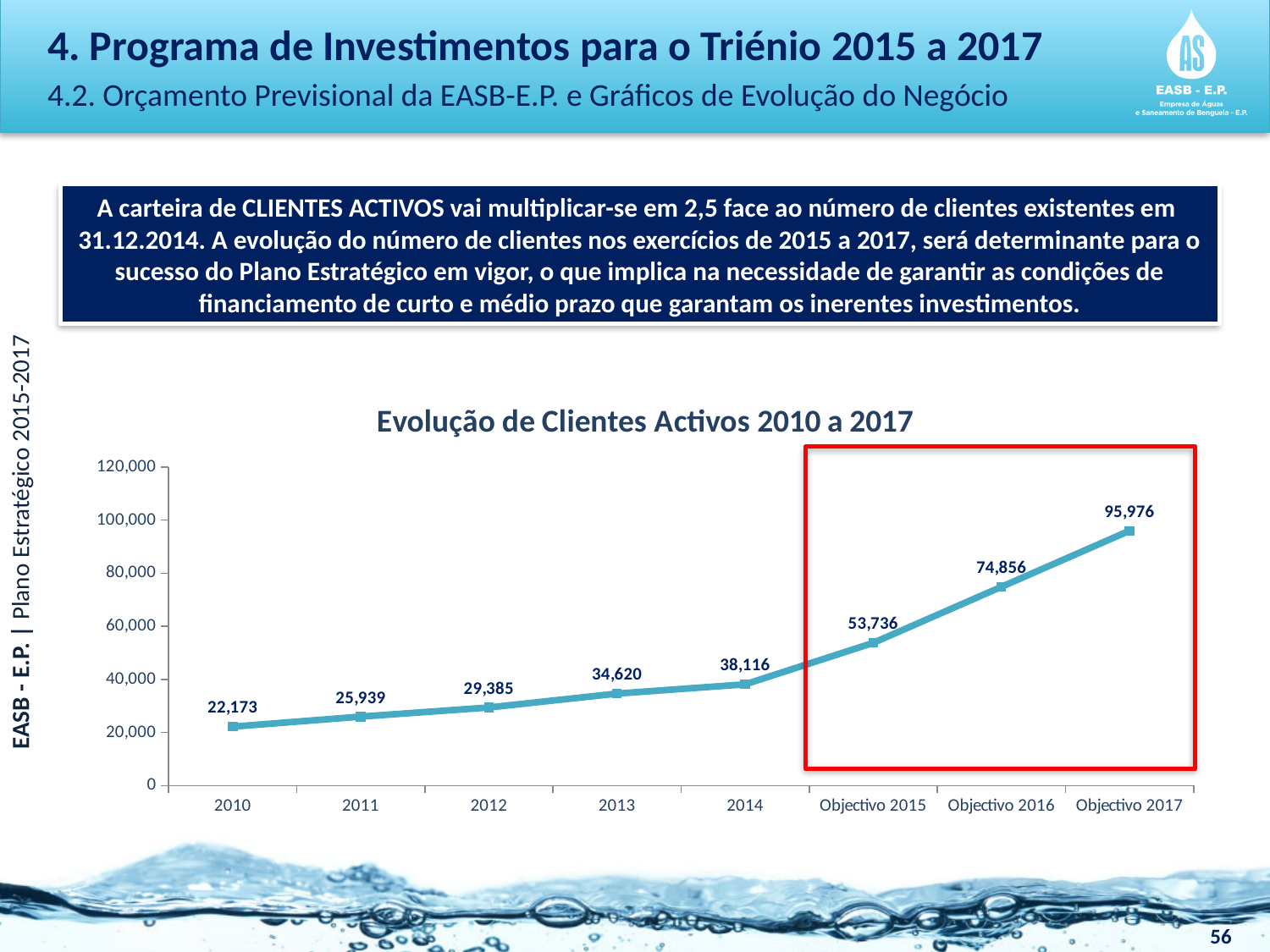
Which is larger, the value for 2013 or the value for Objectivo 2015? Objectivo 2015 Which category has the highest value? Objectivo 2017 What is the difference between the values for Objectivo 2017 and Objectivo 2016? 21,120 What is the difference between the values for 2014 and 2010? 15,943 Do the values rise or fall from 2010 to Objectivo 2017? rise What kind of chart is shown on the slide? line chart What is the value for Objectivo 2016? 74,856 What is the title of the chart? Evolução de Clientes Activos 2010 a 2017 What is the value for 2010? 22,173 What is the value for 2014? 38,116 Which category has the lowest value? 2010 How many data points are plotted on the chart? 8